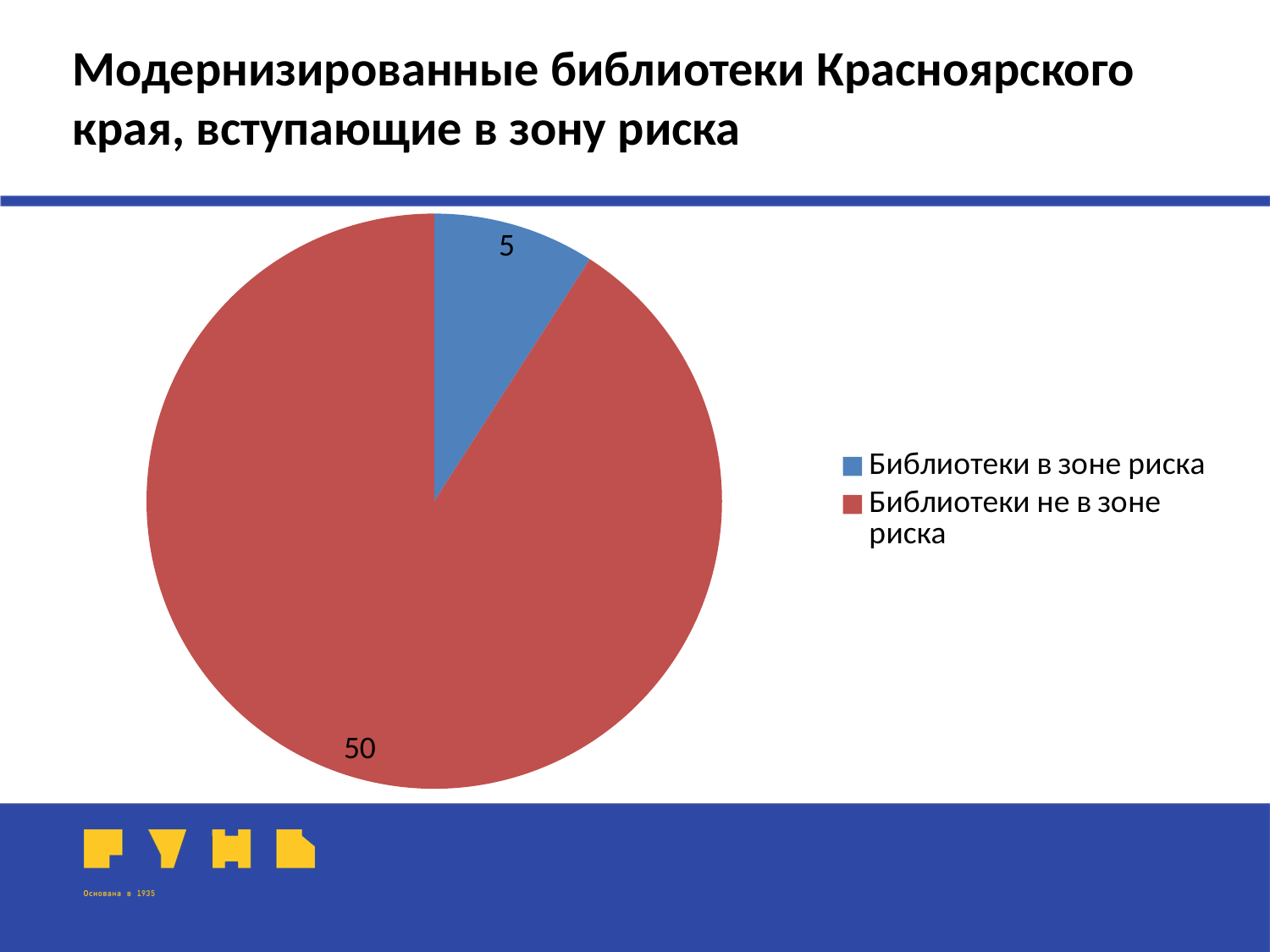
Which category has the smallest slice of the pie? Библиотеки в зоне риска What is the value for "Библиотеки не в зоне риска"? 50 Which category has the largest slice of the pie? Библиотеки не в зоне риска What is the total of all slices in the pie chart? 55 Which is larger: the value for "Библиотеки в зоне риска" or for "Библиотеки не в зоне риска"? Библиотеки не в зоне риска What is the value for "Библиотеки в зоне риска"? 5 What colour is the slice for "Библиотеки в зоне риска"? Blue What kind of chart is shown on the slide? Pie chart How many slices does the pie chart have? 2 What is the difference between the values for "Библиотеки не в зоне риска" and "Библиотеки в зоне риска"? 45 What is the title of the slide containing the chart? Модернизированные библиотеки Красноярского края, вступающие в зону риска How many entries does the legend list? 2